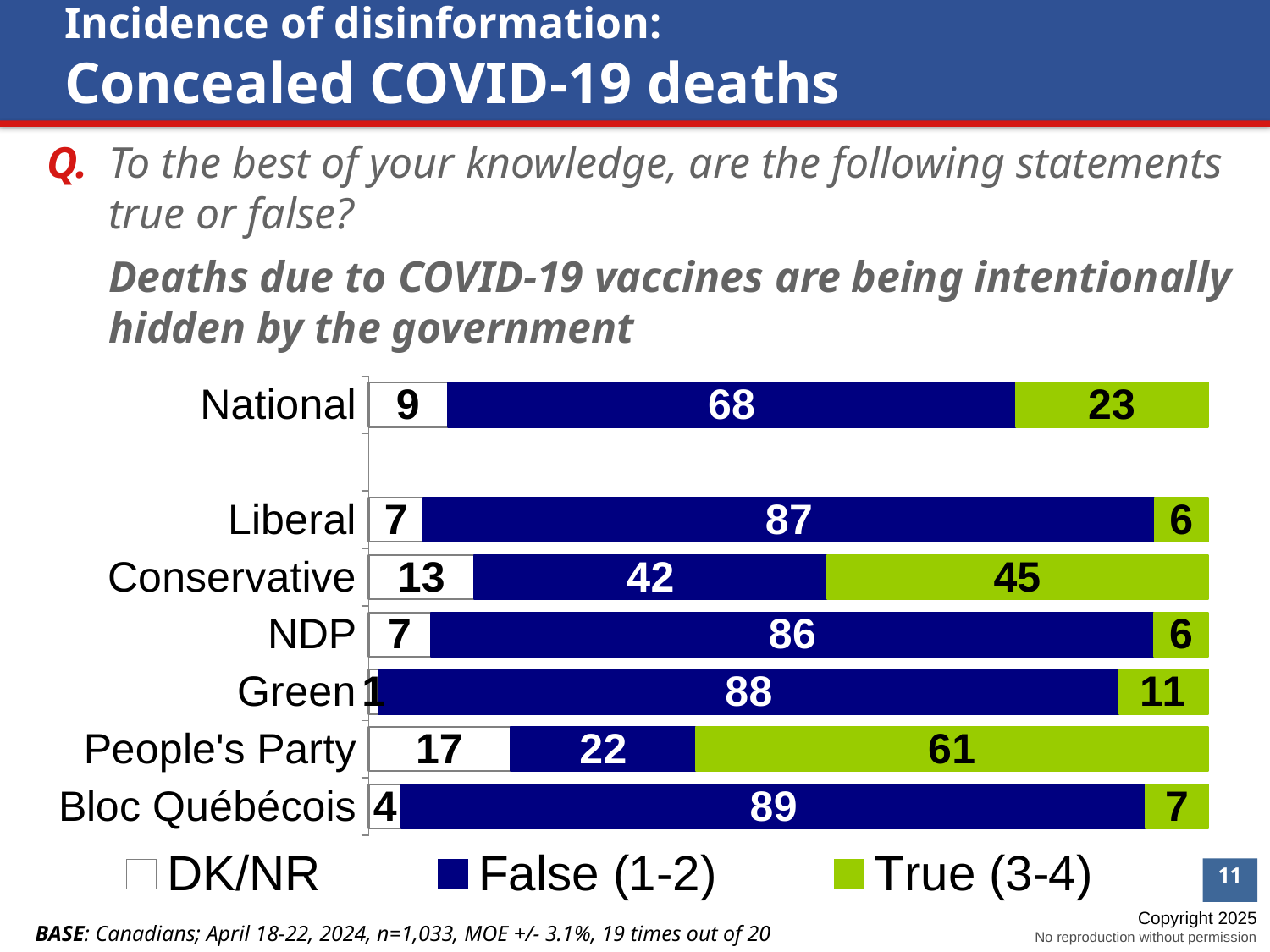
Which is larger, the False (1-2) value for Liberal or for NDP? Liberal What is the difference between the True (3-4) values for People's Party and Conservative? 16 What is the DK/NR value for People's Party? 17 Which category has the highest True (3-4) value? People's Party Which legend entry is shown in green? True (3-4) What is the total of the stacked bar for Green? 100 What is the False (1-2) value for National? 68 How many categories are plotted on the chart? 7 How many series does the legend list? 3 Which category has the lowest False (1-2) value? People's Party What is the True (3-4) value for Conservative? 45 What kind of chart is shown on the slide? Stacked bar chart